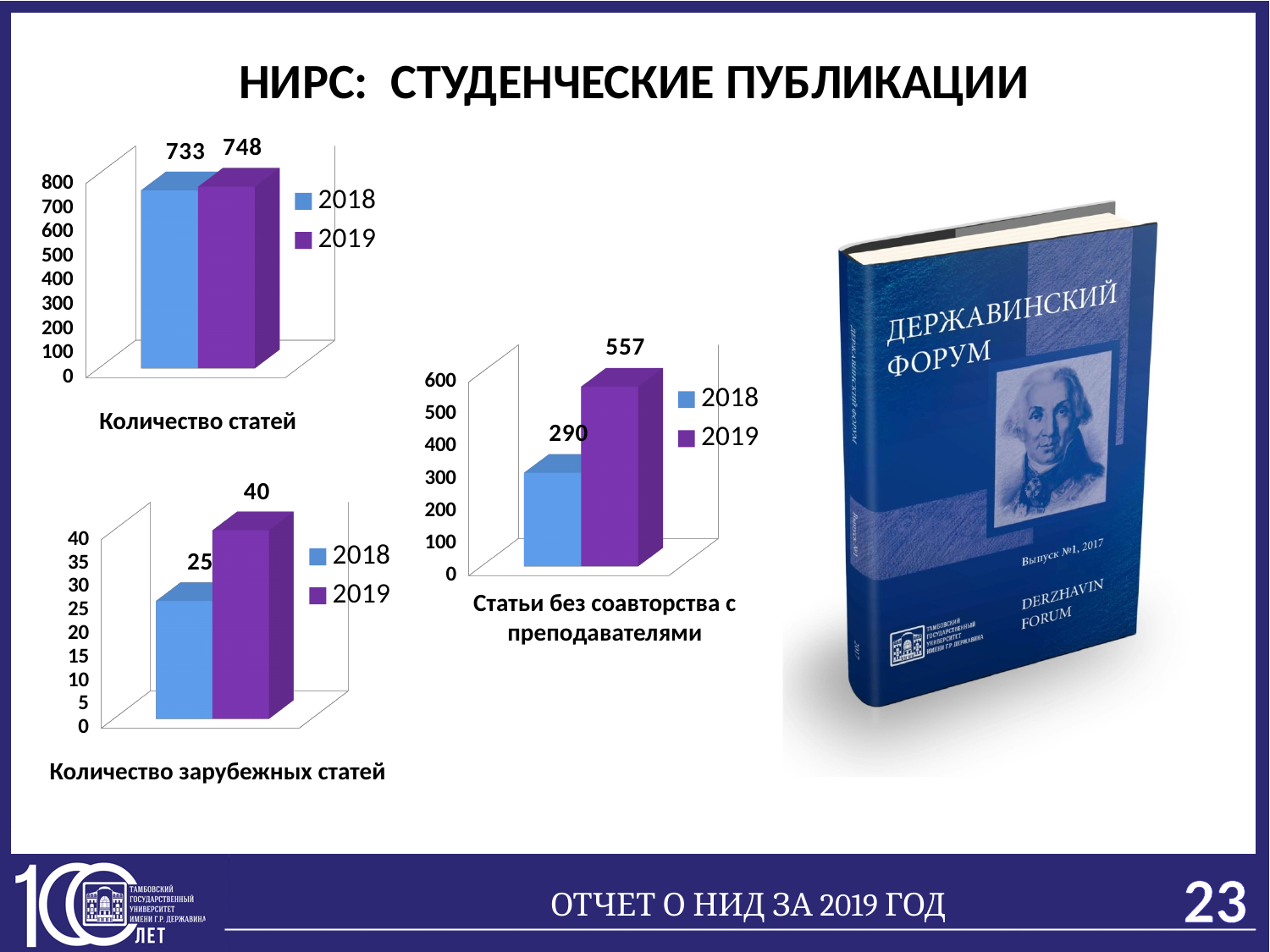
In the chart 'Количество статей', what is the value for 2018? 733 In the chart 'Количество статей', what is the value for 2019? 748 How many series does the legend of the chart 'Количество зарубежных статей' list? 2 In the chart 'Статьи без соавторства с преподавателями', what is the value for 2019? 557 In the chart 'Статьи без соавторства с преподавателями', what is the value for 2018? 290 What kind of chart is 'Количество статей'? Bar chart In the chart 'Статьи без соавторства с преподавателями', what is the difference between the 2019 and 2018 values? 267 In the chart 'Статьи без соавторства с преподавателями', which year has the higher value? 2019 In the chart 'Количество статей', what is the difference between the 2019 and 2018 values? 15 In the chart 'Количество зарубежных статей', which year has the lower value? 2018 In the chart 'Количество зарубежных статей', what is the value for 2018? 25 In the chart 'Количество зарубежных статей', what is the value for 2019? 40